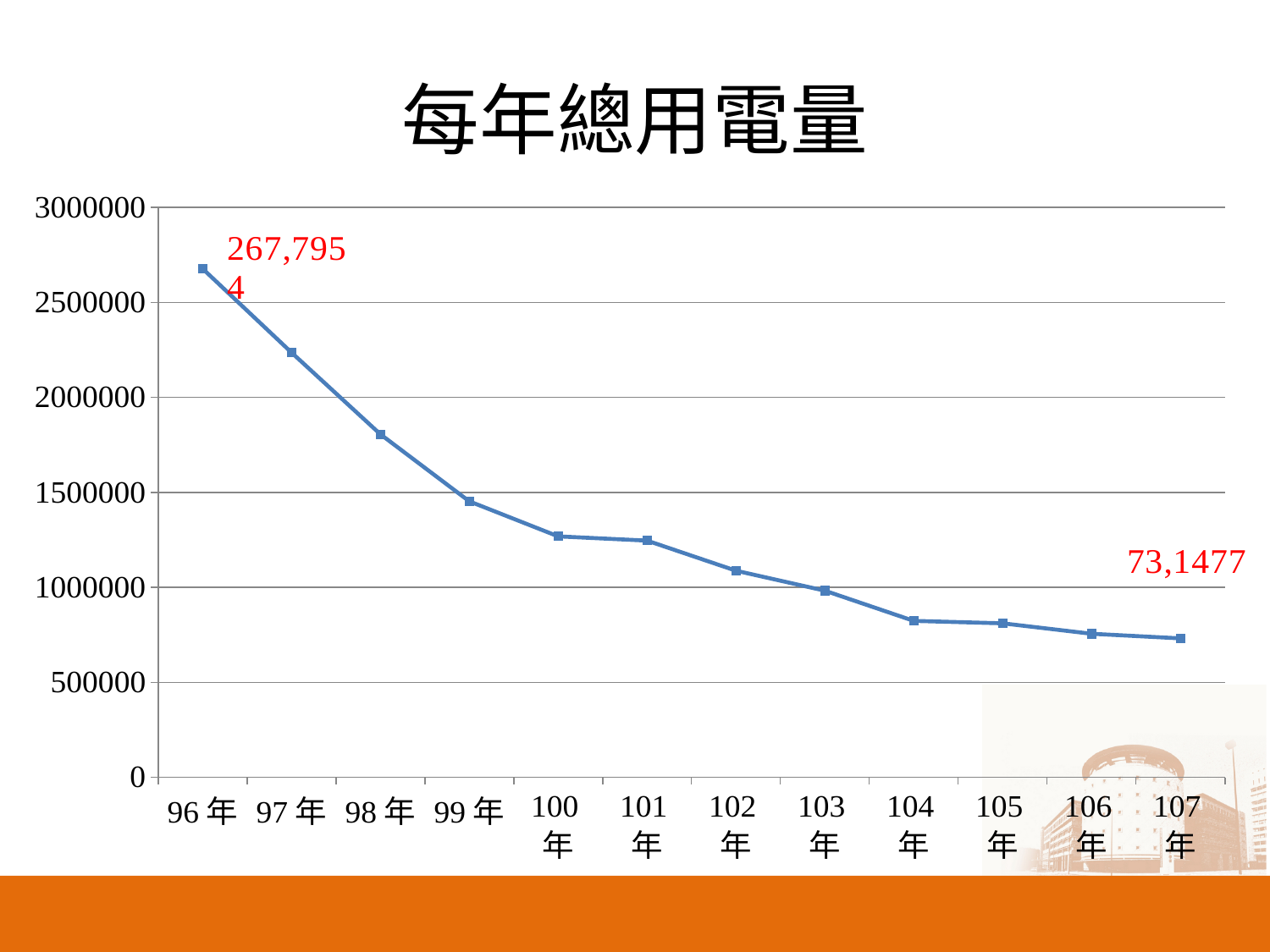
What value is labelled for 96年? 267,7954 Do the values rise or fall from 96年 to 107年? fall Is the value for 99年 greater or less than 1500000? less How many years are plotted on the x axis? 12 What value is labelled for 107年? 73,1477 Which year has the highest total electricity consumption? 96年 What is the title of the chart? 每年總用電量 Is the value for 104年 greater or less than 1000000? less Which year has the lowest total electricity consumption? 107年 Which is larger, the value for 98年 or the value for 101年? 98年 Is the value for 97年 greater or less than 2000000? greater What kind of chart is shown on the slide? line chart